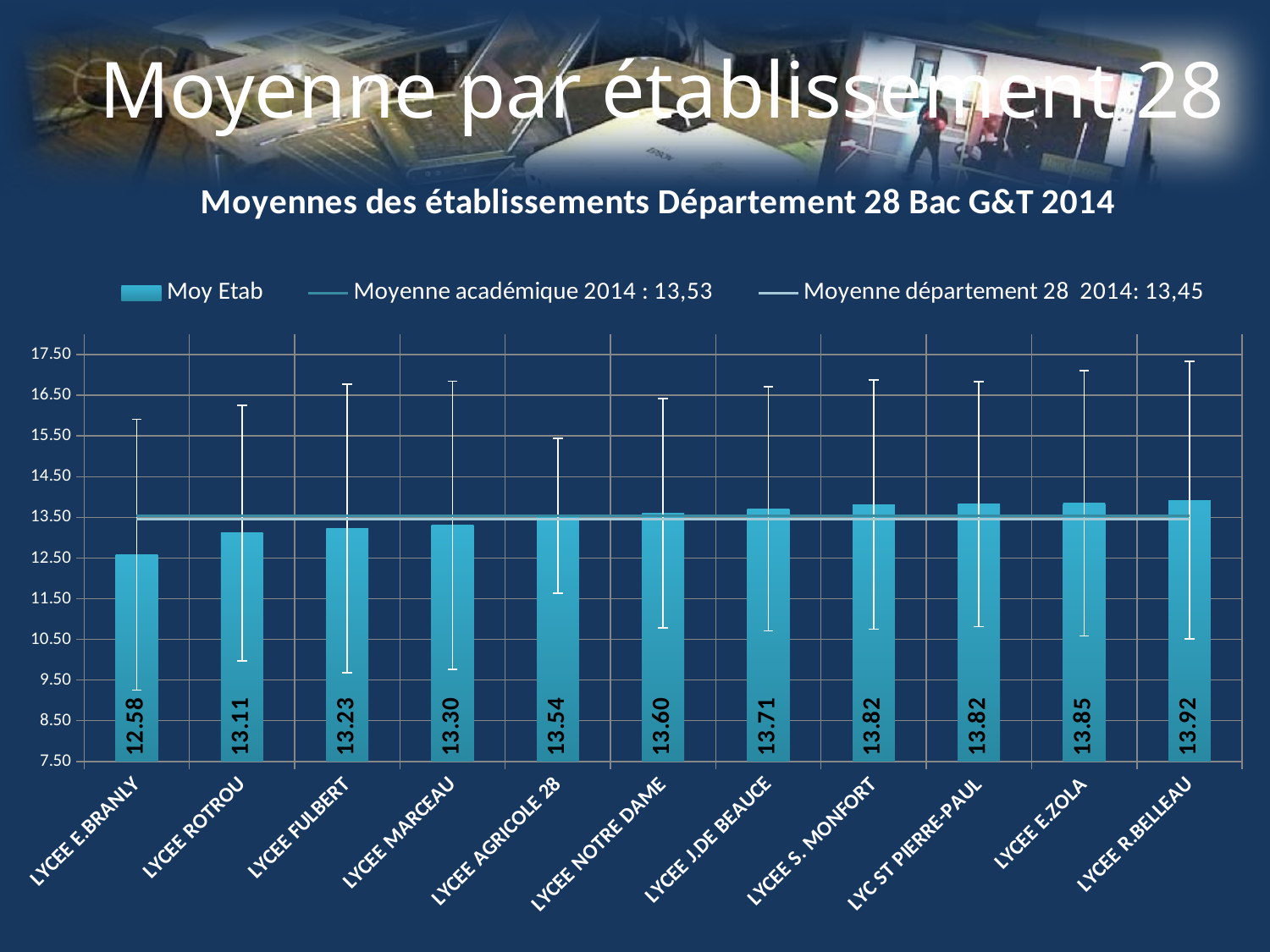
What kind of chart is shown? bar chart Is the value for LYCEE FULBERT greater or less than 13.50? less What is the value for LYCEE NOTRE DAME? 13.60 How many establishments are shown on the x axis? 11 Which is larger, the value for LYCEE ROTROU or the value for LYCEE MARCEAU? LYCEE MARCEAU How many entries does the legend list? 3 What is the value for LYCEE AGRICOLE 28? 13.54 Which establishment has the highest value? LYCEE R.BELLEAU What is the title of the chart? Moyennes des établissements Département 28 Bac G&T 2014 What is the difference between the values for LYCEE R.BELLEAU and LYCEE E.BRANLY? 1.34 Which establishment has the lowest value? LYCEE E.BRANLY What is the value for LYCEE E.BRANLY? 12.58